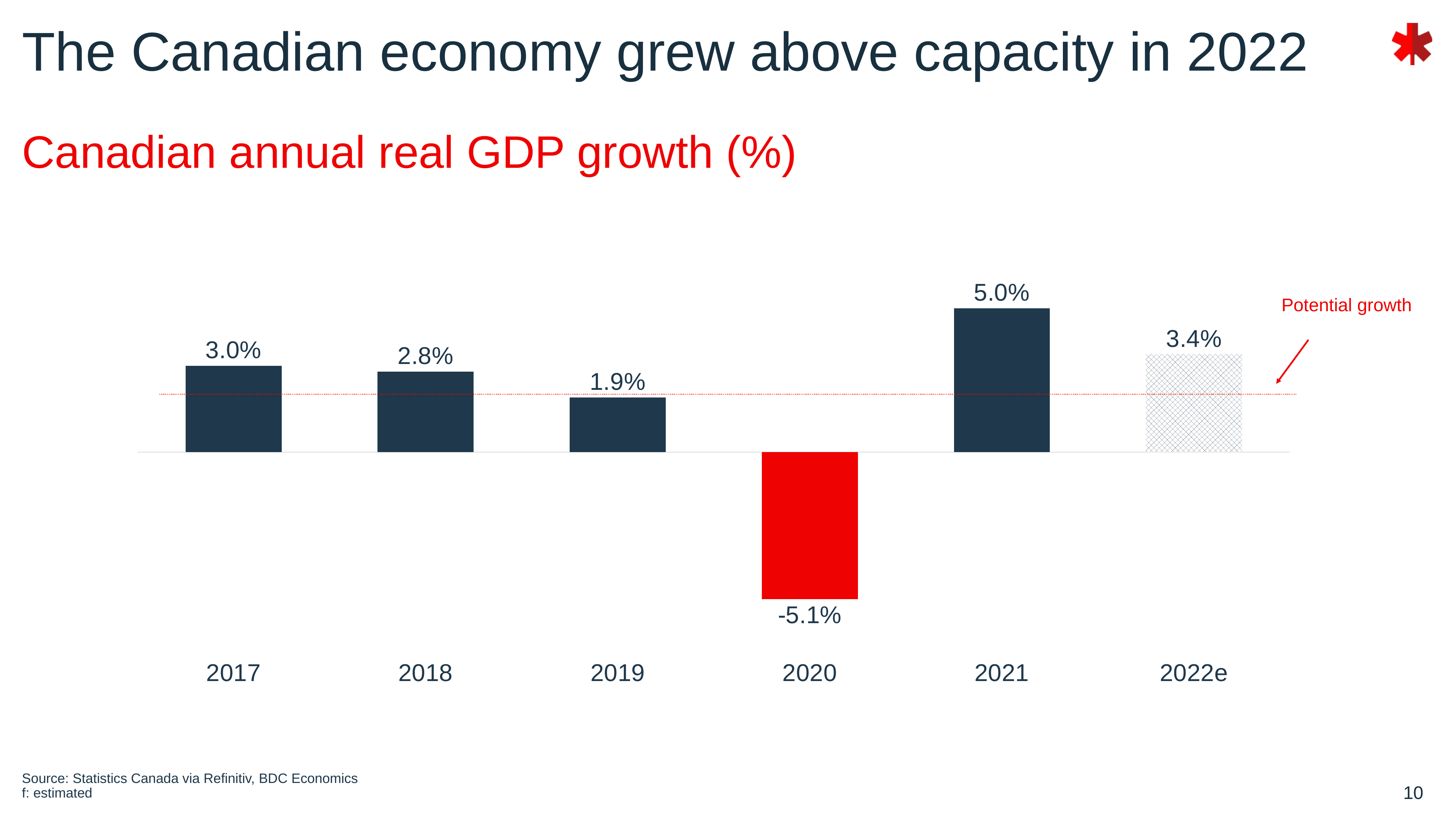
Which year has the highest real GDP growth in the chart? 2021 What is the Canadian annual real GDP growth shown for 2020? -5.1% How many years are shown on the x axis of the chart? 6 What is the Canadian annual real GDP growth shown for 2021? 5.0% What is the difference in real GDP growth between 2017 and 2018? 0.2 percentage points What does the red dotted horizontal line in the chart represent? Potential growth Which year has the lowest real GDP growth in the chart? 2020 Which year had higher real GDP growth, 2017 or 2019? 2017 What is the difference in real GDP growth between 2021 and 2022e? 1.6 percentage points What is the Canadian annual real GDP growth shown for 2019? 1.9% What is the estimated Canadian annual real GDP growth shown for 2022e? 3.4% What type of chart is used to show Canadian annual real GDP growth? Bar chart